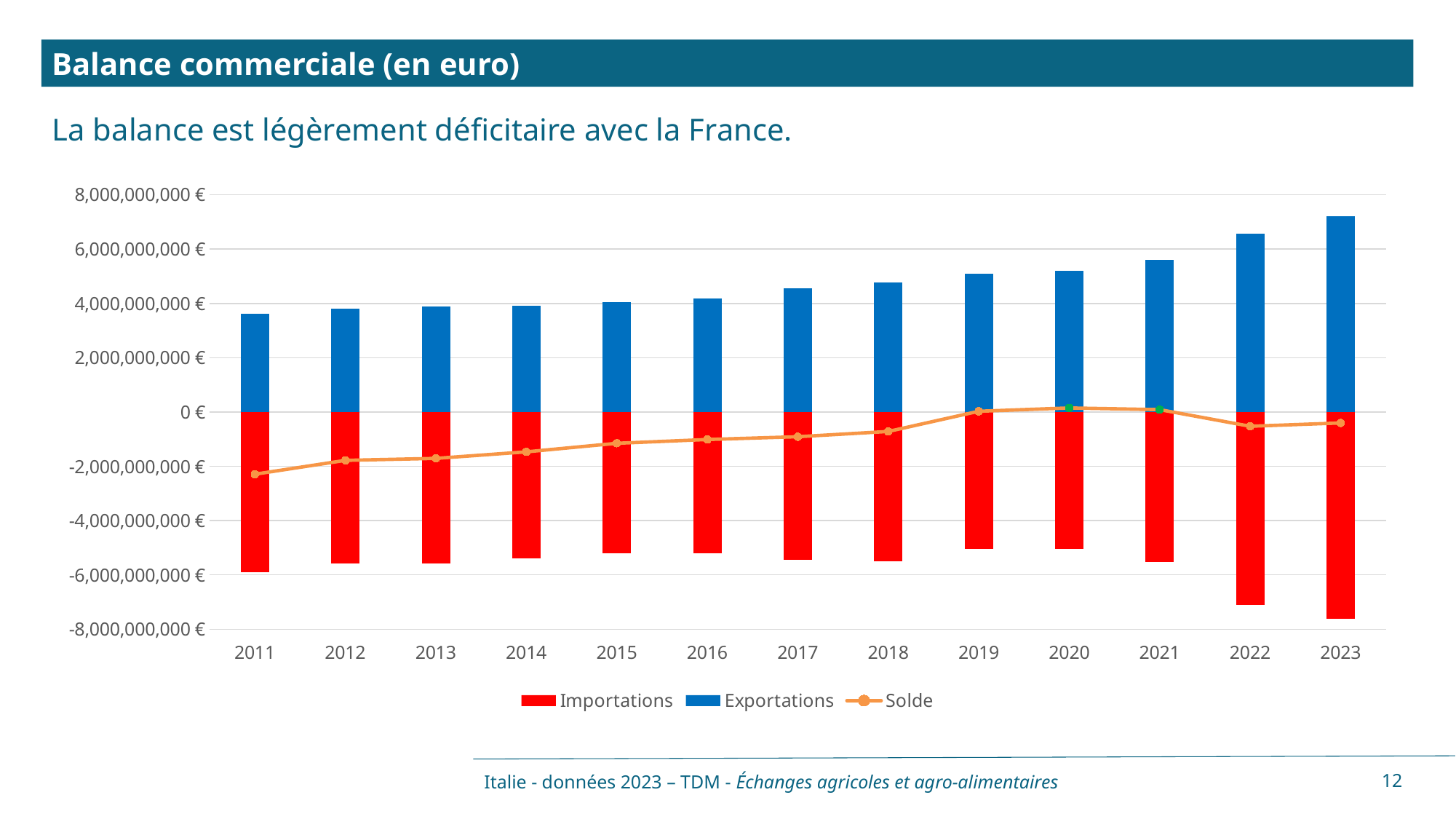
What kind of chart is shown on the slide? bar chart with a line Is the Importations value for 2023 greater or less than -6,000,000,000 €? less Is the Exportations value for 2023 greater or less than 6,000,000,000 €? greater Is the Solde value for 2011 greater or less than -2,000,000,000 €? less Which year has the lowest Exportations value? 2011 How many years are shown on the x axis? 13 How many series does the legend list? 3 Do the Exportations values rise or fall from 2011 to 2023? rise Which is larger, the Exportations value for 2022 or for 2019? 2022 What are the three entries listed in the legend? Importations, Exportations, Solde Which year has the highest Exportations value? 2023